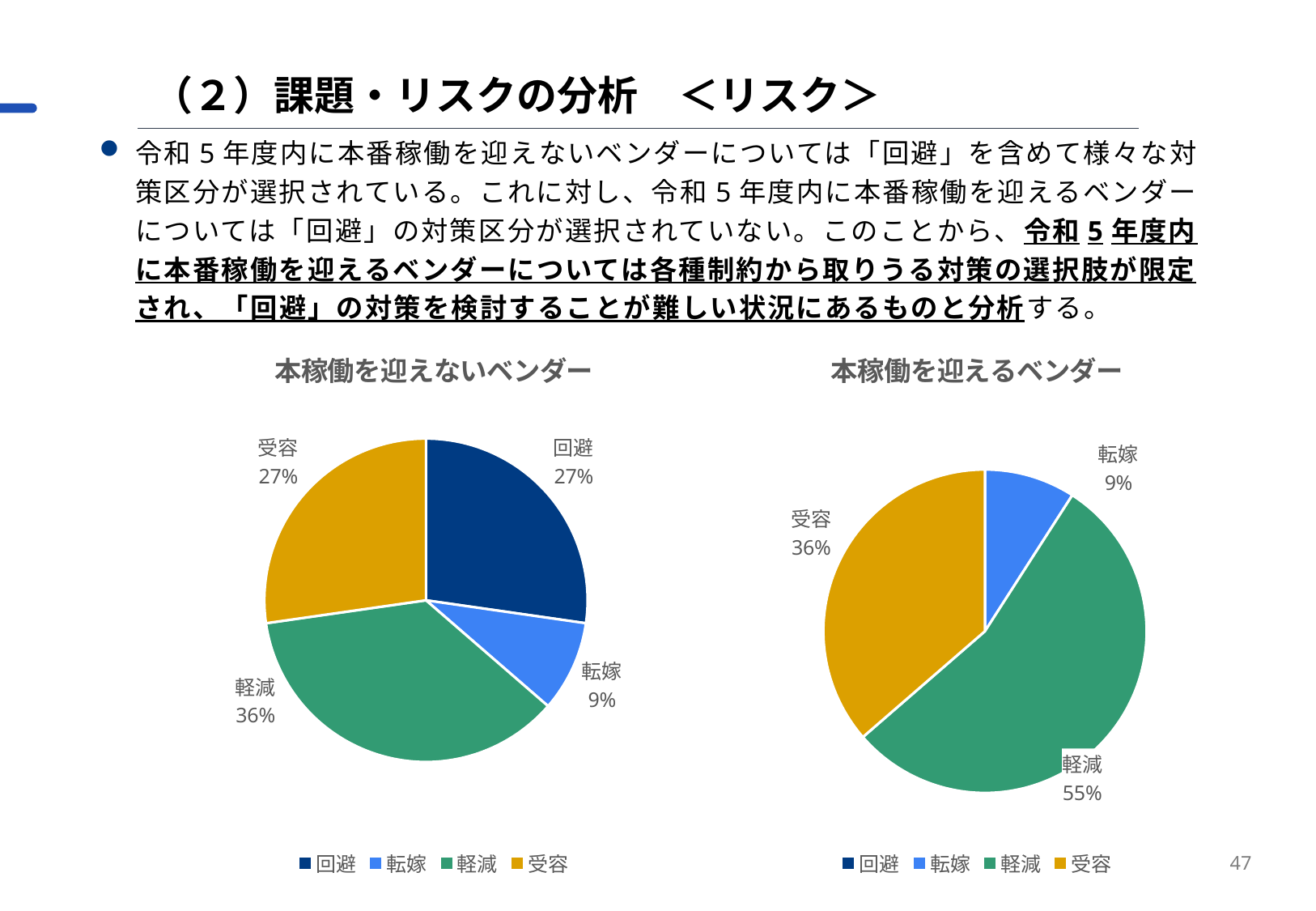
In the 本稼働を迎えないベンダー chart, what share does 回避 have? 27% In the 本稼働を迎えないベンダー chart, what is the difference between the shares of 軽減 and 転嫁? 27% What type of chart is used on this slide? Pie chart In the 本稼働を迎えないベンダー chart, which category has the smallest share? 転嫁 In the 本稼働を迎えるベンダー chart, what is the difference between the shares of 軽減 and 受容? 19% How many slices are shown in the 本稼働を迎えるベンダー chart? 3 In the 本稼働を迎えるベンダー chart, which category has the largest share? 軽減 How many entries does the legend of the 本稼働を迎えないベンダー chart list? 4 In the 本稼働を迎えないベンダー chart, what share does 軽減 have? 36% In the 本稼働を迎えるベンダー chart, what share does 受容 have? 36% Which chart has the larger share for 軽減, 本稼働を迎えないベンダー or 本稼働を迎えるベンダー? 本稼働を迎えるベンダー In the 本稼働を迎えるベンダー chart, what share does 軽減 have? 55%